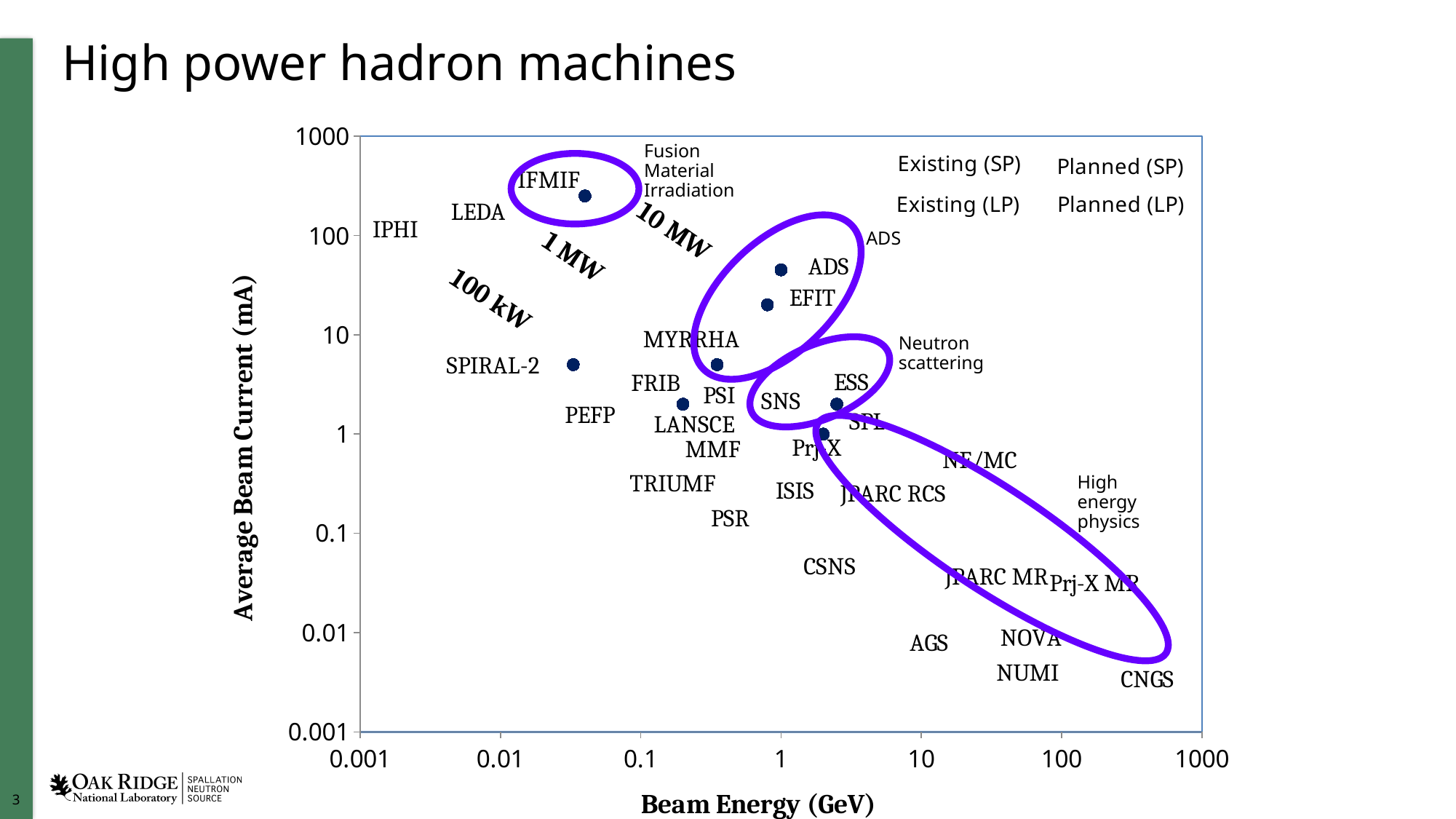
Is the average beam current for ADS greater or less than 10 mA? greater Is the beam energy for SPIRAL-2 greater or less than 0.1 GeV? less Which plotted machine has the highest average beam current? IFMIF Is the average beam current for SNS greater or less than 10 mA? less Which has the higher beam energy, SPIRAL-2 or MYRRHA? MYRRHA What is the title of the y axis? Average Beam Current (mA) What is the title of the x axis? Beam Energy (GeV) How many series does the legend list? 4 What kind of chart is shown on the slide? scatter chart Which has the higher average beam current, IFMIF or ADS? IFMIF